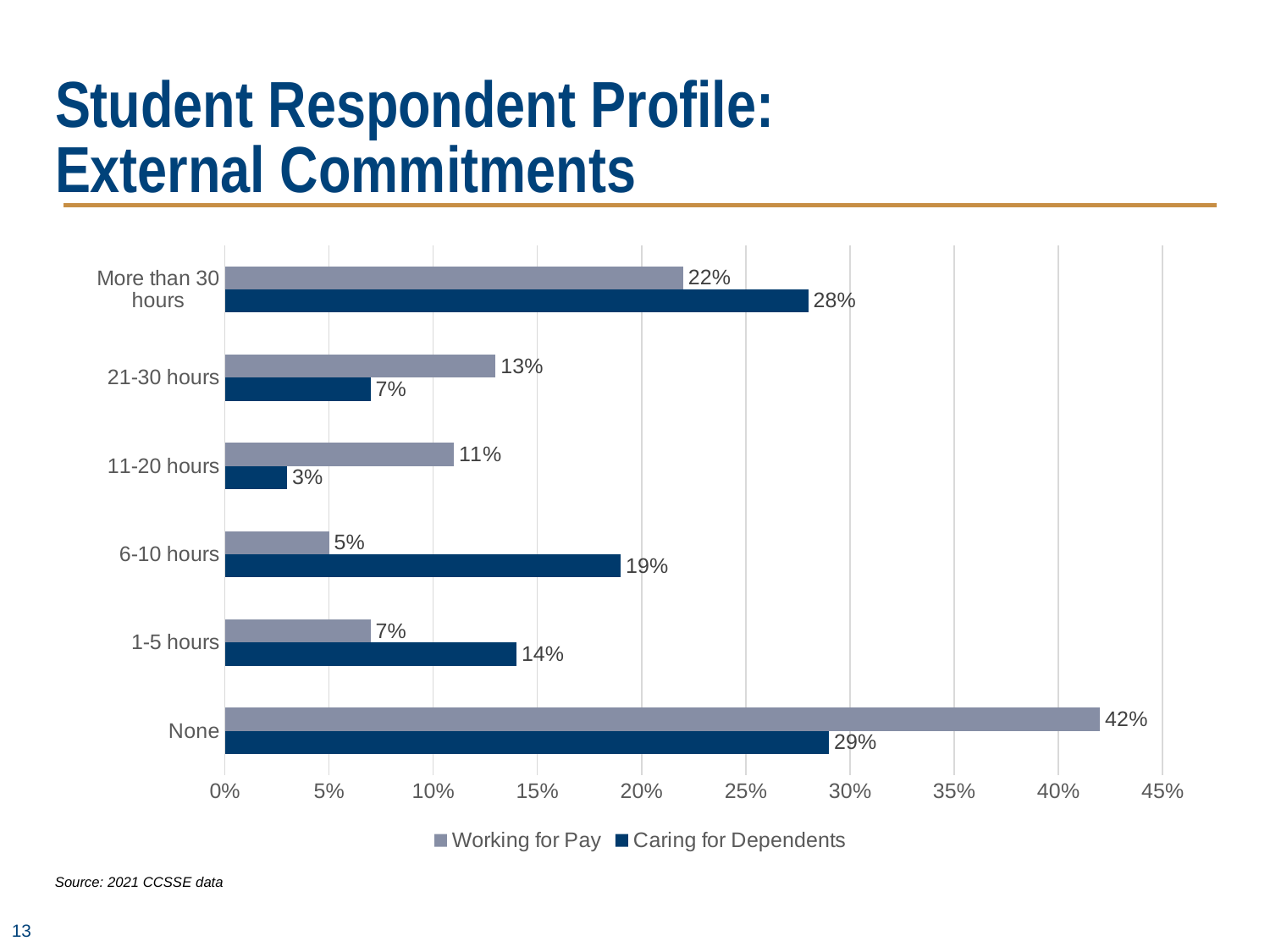
What type of chart is shown on the slide? Bar chart What is the source of the data cited on the slide? 2021 CCSSE data Which category has the highest value for Caring for Dependents? None In the 1-5 hours category, which series has the larger value, Working for Pay or Caring for Dependents? Caring for Dependents What is the value for Working for Pay in the None category? 42% How many series does the legend list? 2 How many hour categories are shown on the chart? 6 What is the difference between Working for Pay and Caring for Dependents in the 11-20 hours category? 8% What is the value for Caring for Dependents in the 6-10 hours category? 19% Which category has the lowest value for Working for Pay? 6-10 hours What percentage of respondents report working for pay more than 30 hours? 22% Is the value for Caring for Dependents in the More than 30 hours category greater or less than 25%? greater